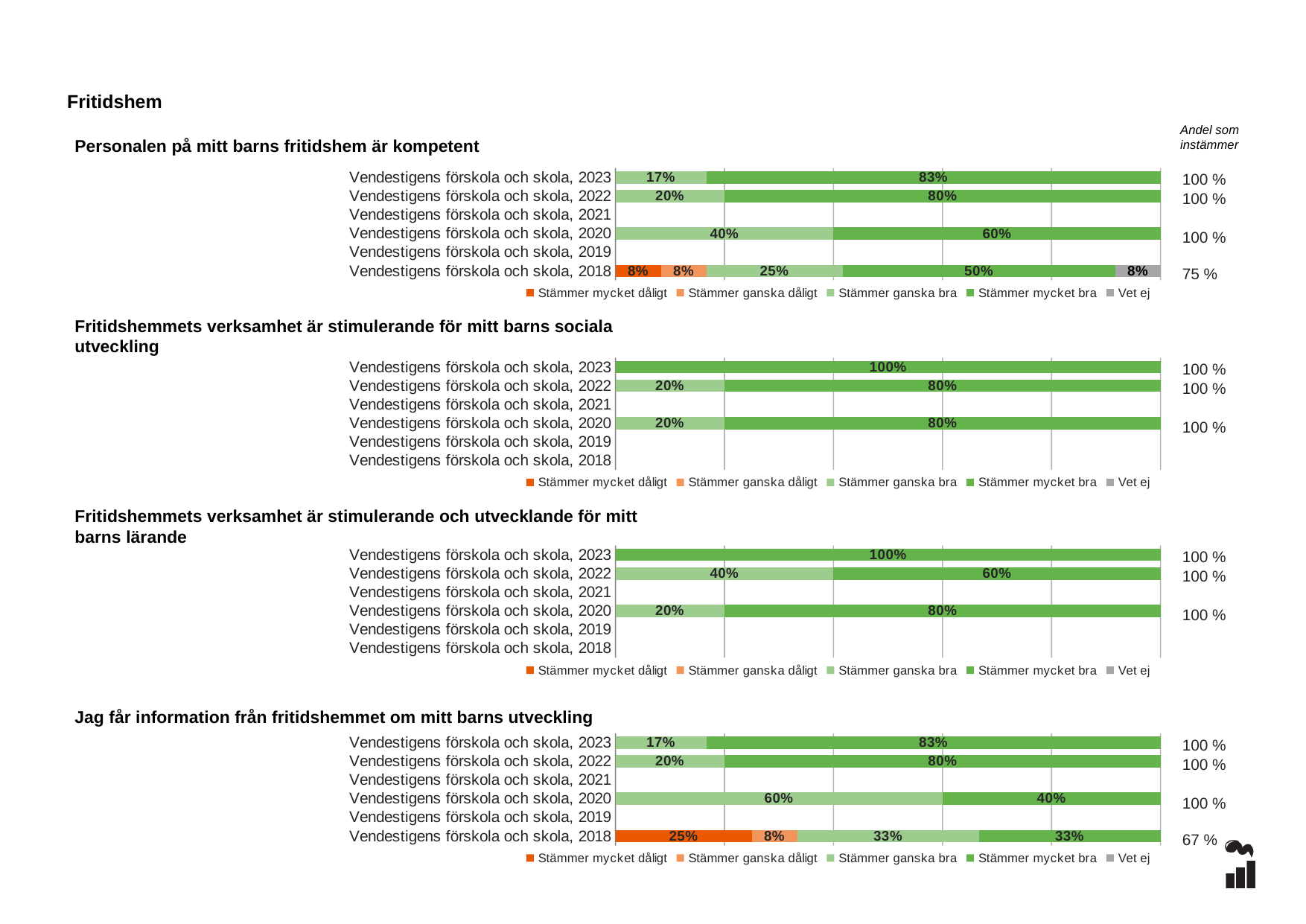
In the chart 'Jag får information från fritidshemmet om mitt barns utveckling', what is the difference between the 'Stämmer ganska bra' and 'Stämmer mycket bra' values for Vendestigens förskola och skola, 2020? 20% In the chart 'Fritidshemmets verksamhet är stimulerande för mitt barns sociala utveckling', what is the 'Stämmer mycket bra' value for Vendestigens förskola och skola, 2023? 100% How many series does the legend list in the chart 'Personalen på mitt barns fritidshem är kompetent'? 5 In the chart 'Jag får information från fritidshemmet om mitt barns utveckling', which is larger for Vendestigens förskola och skola, 2020: 'Stämmer ganska bra' or 'Stämmer mycket bra'? Stämmer ganska bra In the chart 'Fritidshemmets verksamhet är stimulerande och utvecklande för mitt barns lärande', what is the 'Stämmer ganska bra' value for Vendestigens förskola och skola, 2022? 40% In the chart 'Jag får information från fritidshemmet om mitt barns utveckling', what is the 'Andel som instämmer' value for Vendestigens förskola och skola, 2018? 67 % What kind of chart is 'Fritidshemmets verksamhet är stimulerande för mitt barns sociala utveckling'? Stacked bar chart In the chart 'Personalen på mitt barns fritidshem är kompetent', what is the 'Stämmer mycket bra' value for Vendestigens förskola och skola, 2023? 83% In the chart 'Personalen på mitt barns fritidshem är kompetent', what is the 'Vet ej' value for Vendestigens förskola och skola, 2018? 8% In the chart 'Personalen på mitt barns fritidshem är kompetent', what is the 'Andel som instämmer' value for Vendestigens förskola och skola, 2018? 75 % In the chart 'Personalen på mitt barns fritidshem är kompetent', what is the 'Stämmer ganska bra' value for Vendestigens förskola och skola, 2020? 40% In the chart 'Jag får information från fritidshemmet om mitt barns utveckling', what is the 'Stämmer mycket dåligt' value for Vendestigens förskola och skola, 2018? 25%